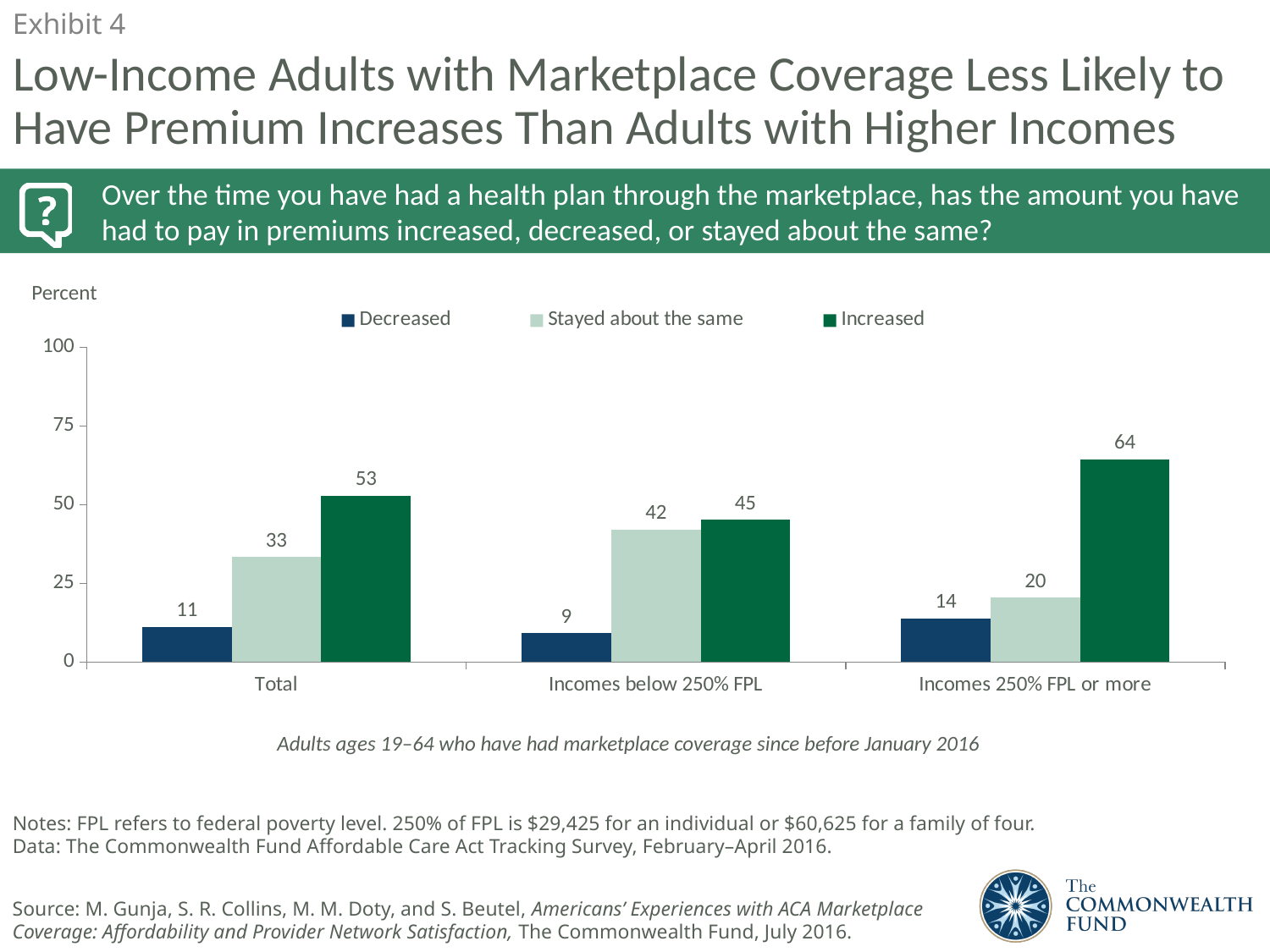
What percentage of adults with incomes 250% FPL or more said their premiums decreased? 14 Is the 'Increased' value for the Total group greater or less than 50? greater Which income group has the highest value for 'Increased'? Incomes 250% FPL or more What percentage of adults with incomes below 250% FPL said their premiums increased? 45 What kind of chart is shown on the slide? Bar chart What is the value for 'Stayed about the same' in the Total group? 33 What is the label on the y axis? Percent Which is larger for incomes below 250% FPL: 'Stayed about the same' or 'Increased'? Increased How many income categories are shown on the x axis? 3 What is the difference between the 'Increased' values for incomes 250% FPL or more and incomes below 250% FPL? 19 How many series does the legend list? 3 Which group has the lowest value for 'Decreased'? Incomes below 250% FPL